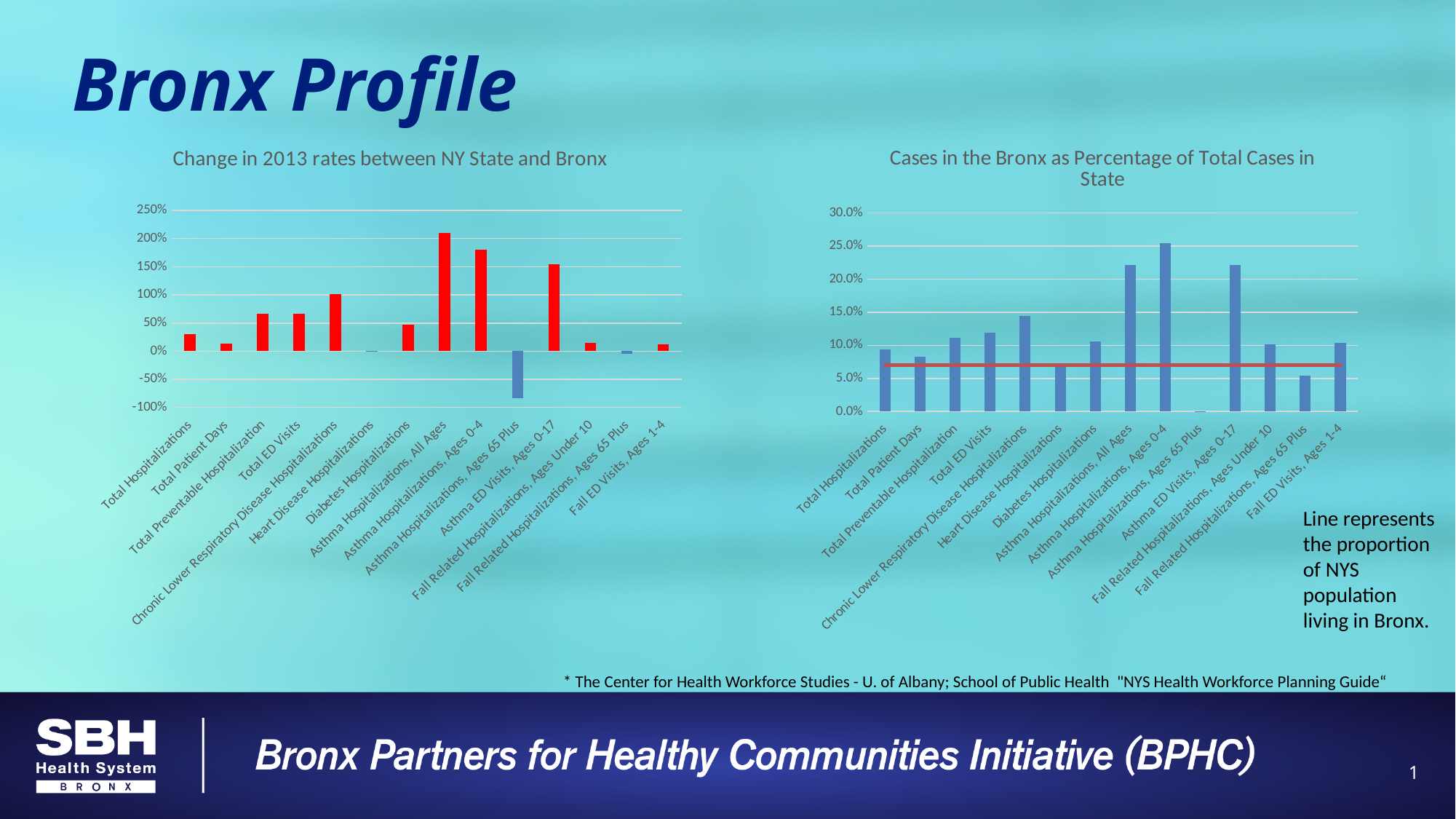
On the 'Cases in the Bronx as Percentage of Total Cases in State' chart, is the value for Chronic Lower Respiratory Disease Hospitalizations greater or less than 10.0%? greater On the 'Cases in the Bronx as Percentage of Total Cases in State' chart, which is larger: Total ED Visits or Total Patient Days? Total ED Visits On the 'Cases in the Bronx as Percentage of Total Cases in State' chart, which category has the lowest value? Asthma Hospitalizations, Ages 65 Plus On the 'Change in 2013 rates between NY State and Bronx' chart, is the value for Asthma ED Visits, Ages 0-17 greater or less than 100%? greater On the 'Change in 2013 rates between NY State and Bronx' chart, which category has the highest value? Asthma Hospitalizations, All Ages How many categories are shown on the 'Change in 2013 rates between NY State and Bronx' chart? 14 On the 'Change in 2013 rates between NY State and Bronx' chart, is the value for Total Patient Days greater or less than 50%? less What kind of chart is the 'Change in 2013 rates between NY State and Bronx' chart? bar chart On the 'Change in 2013 rates between NY State and Bronx' chart, which is larger: Chronic Lower Respiratory Disease Hospitalizations or Diabetes Hospitalizations? Chronic Lower Respiratory Disease Hospitalizations On the 'Change in 2013 rates between NY State and Bronx' chart, which category has the lowest value? Asthma Hospitalizations, Ages 65 Plus According to the slide, what does the horizontal line on the 'Cases in the Bronx as Percentage of Total Cases in State' chart represent? The proportion of NYS population living in Bronx On the 'Cases in the Bronx as Percentage of Total Cases in State' chart, which category has the highest value? Asthma Hospitalizations, Ages 0-4